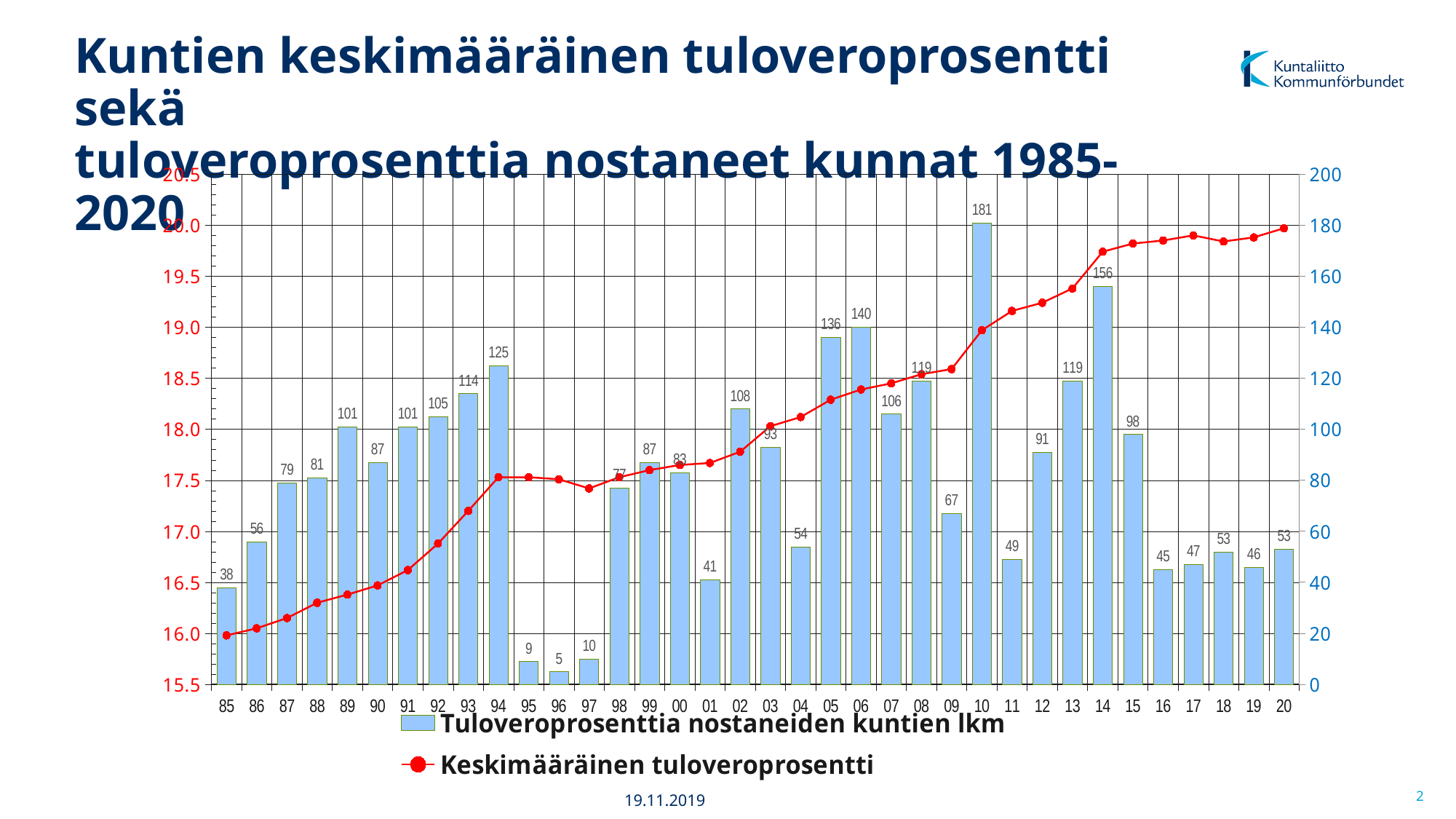
What kind of chart is shown on the slide? A combined bar and line chart In which year was the number of municipalities that raised their income tax rate highest? 2010 Is the average income tax rate (Keskimääräinen tuloveroprosentti) in 2020 greater or less than 19.5? greater What is the number of municipalities that raised their income tax rate in 2014? 156 How many years are shown on the x axis? 36 Does the average income tax rate line generally rise or fall from 1985 to 2020? Rise Which year had more municipalities raising their income tax rate, 2013 or 2012? 2013 What is the difference between the number of municipalities that raised their tax rate in 2006 and in 2005? 4 What is the number of municipalities that raised their income tax rate (Tuloveroprosenttia nostaneiden kuntien lkm) in 2010? 181 In which year was the number of municipalities that raised their income tax rate lowest? 1996 What is the number of municipalities that raised their income tax rate in 1996? 5 How many series does the legend list? 2